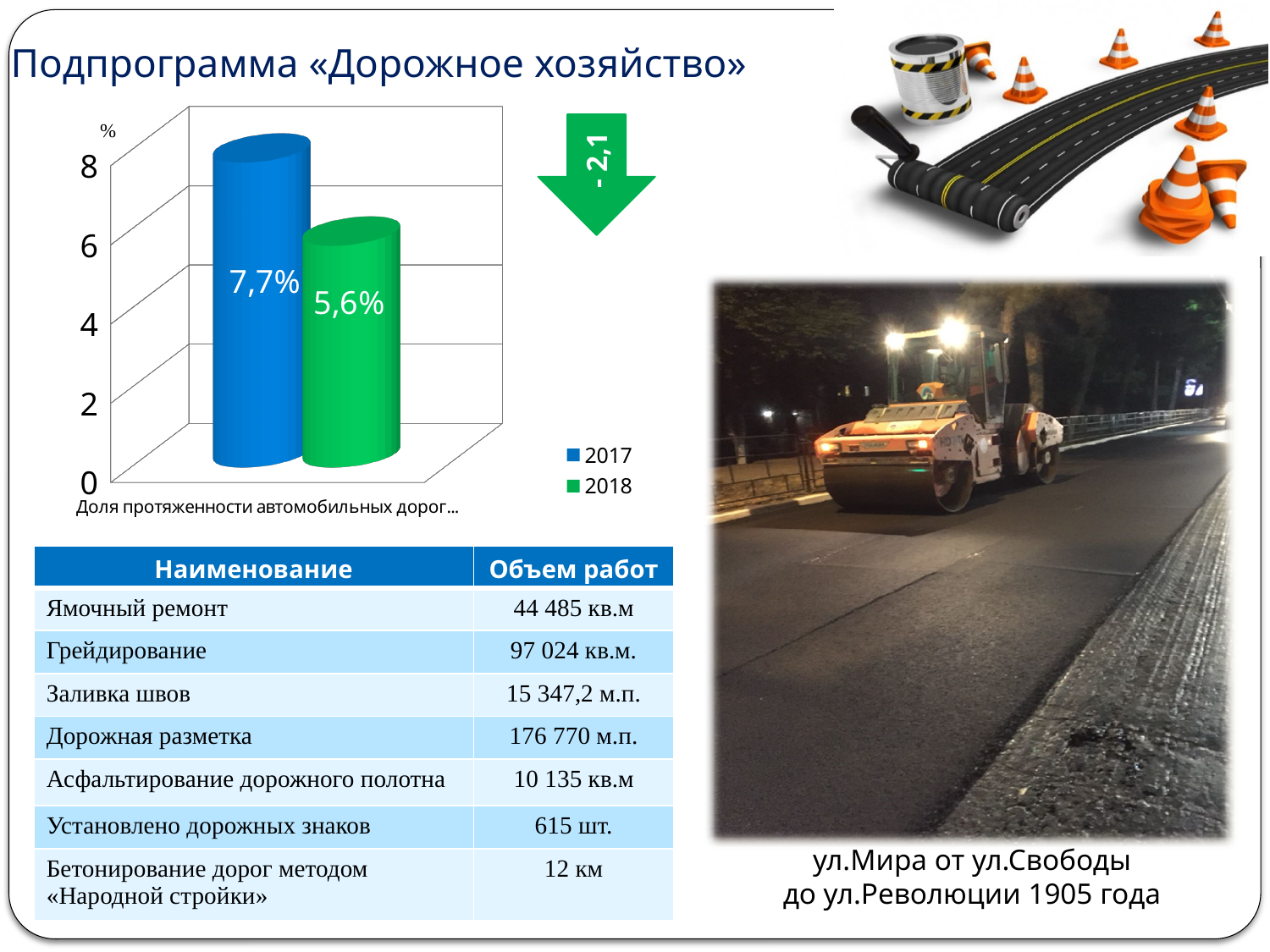
What is the value for 2017 in the chart? 7,7% How many series does the chart's legend list? 2 What colour is the bar for 2018 in the chart? green Do the values fall or rise from 2017 to 2018 in the chart? fall What is the value for 2018 in the chart? 5,6% Which series has the higher value in the chart, 2017 or 2018? 2017 Is the value for 2018 greater or less than 6 on the chart's axis? less Which series has the highest value in the chart? 2017 What kind of chart is shown on the slide? bar chart By how many percentage points does the 2017 value exceed the 2018 value in the chart? 2,1 Is the value for 2017 greater or less than 6 on the chart's axis? greater Which series has the lowest value in the chart? 2018